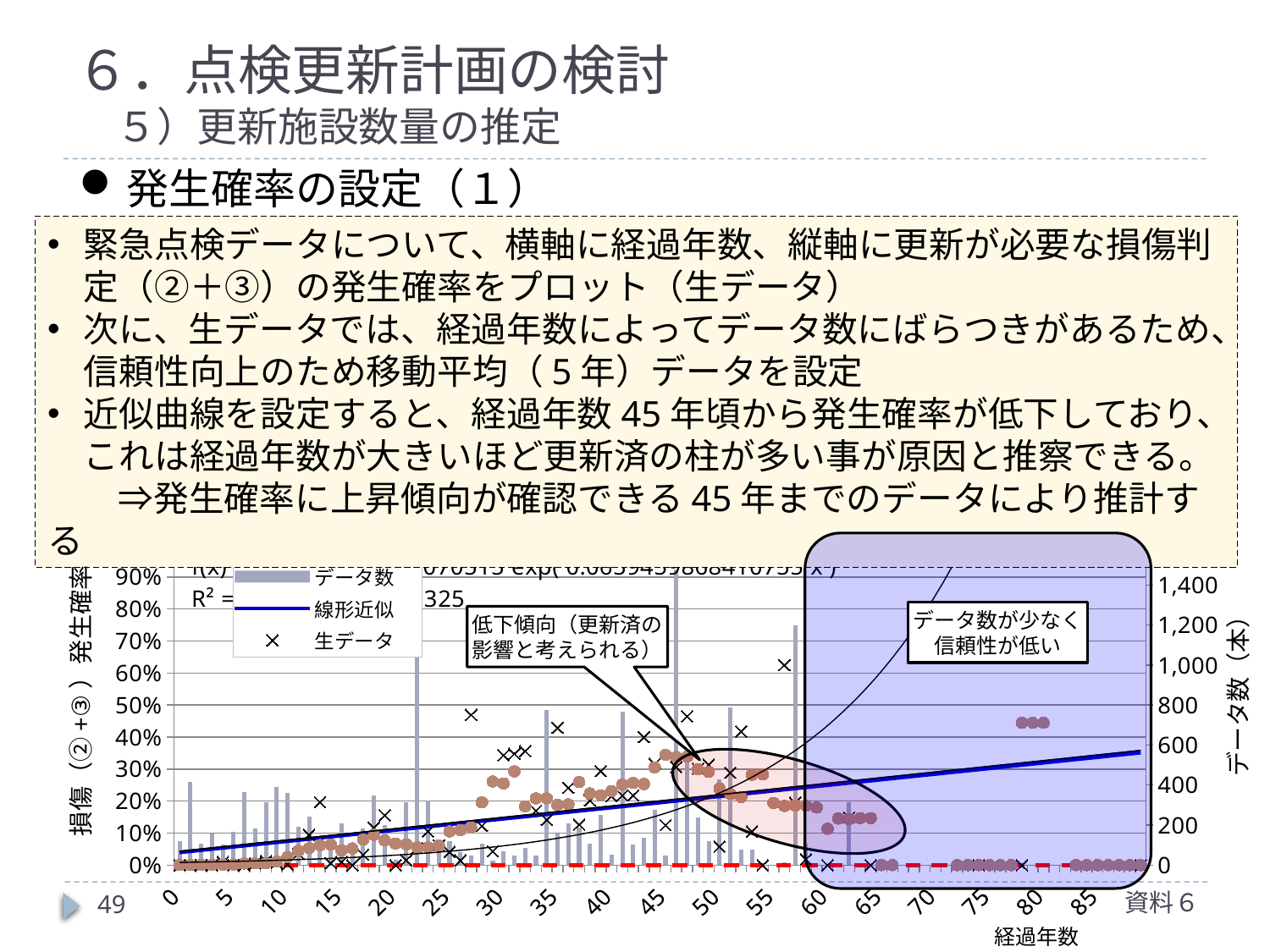
Does the 線形近似 line rise or fall as 経過年数 increases? rise Is the 線形近似 value at 経過年数 0 greater or less than 10%? less How many tick labels are shown on the x axis from 0 to 85? 18 What is the largest 経過年数 tick label shown on the x axis? 85 Is the 生データ value at 経過年数 57 greater or less than 50%? less Is the 線形近似 value at 経過年数 85 greater or less than 30%? greater Which legend entry is drawn as a blue line? 線形近似 What is the title of the x axis of the chart? 経過年数 What kind of chart is shown on the slide? A combination chart of bars, a line and scatter points